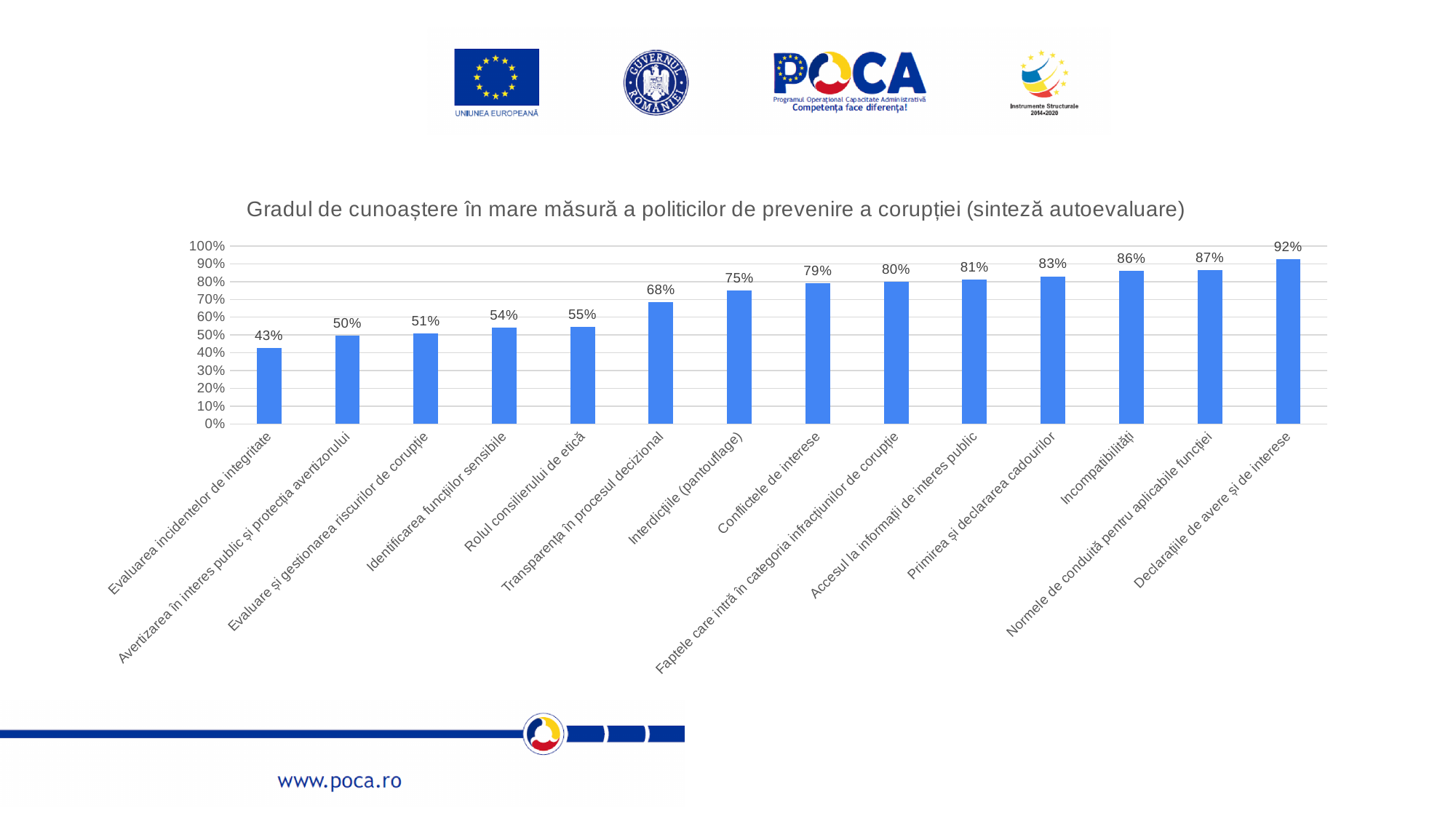
Is the value for Primirea și declararea cadourilor greater or less than 70%? greater What is the value for Rolul consilierului de etică? 55% What is the difference between the values for Declarațiile de avere și de interese and Evaluarea incidentelor de integritate? 49% How many categories are shown in the chart? 14 What is the value for Conflictele de interese? 79% What is the title of the chart? Gradul de cunoaștere în mare măsură a politicilor de prevenire a corupției (sinteză autoevaluare) What kind of chart is shown on the slide? Bar chart Which category has the highest value? Declarațiile de avere și de interese Which is larger, the value for Interdicțiile (pantouflage) or the value for Transparența în procesul decizional? Interdicțiile (pantouflage) Which category has the lowest value? Evaluarea incidentelor de integritate Do the values rise or fall from left to right along the x axis? Rise What is the value for Incompatibilitățile? 86%